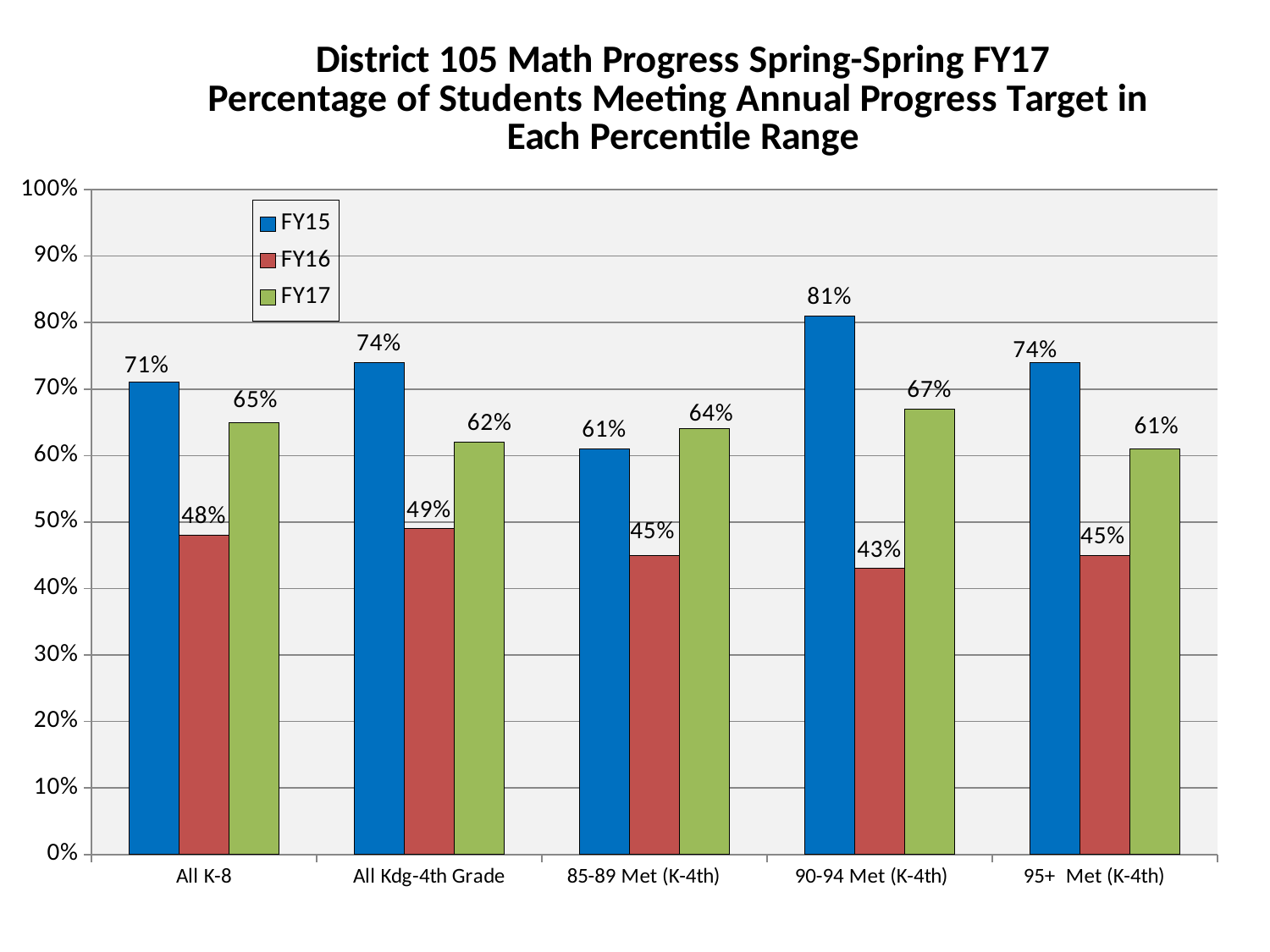
Which colour represents FY16 in the legend? Red Which is larger for 85-89 Met (K-4th): the FY15 value or the FY17 value? FY17 How many series does the legend list? 3 How many categories are shown on the x axis? 5 What is the FY17 value for 85-89 Met (K-4th)? 64% What kind of chart is shown on the slide? Bar chart What is the difference between the FY15 and FY16 values for All Kdg-4th Grade? 25% What is the FY15 value for All K-8? 71% Is the FY17 value for 95+ Met (K-4th) greater or less than 50%? greater Which category has the lowest FY16 value? 90-94 Met (K-4th) What is the FY16 value for 90-94 Met (K-4th)? 43% Which category has the highest FY15 value? 90-94 Met (K-4th)